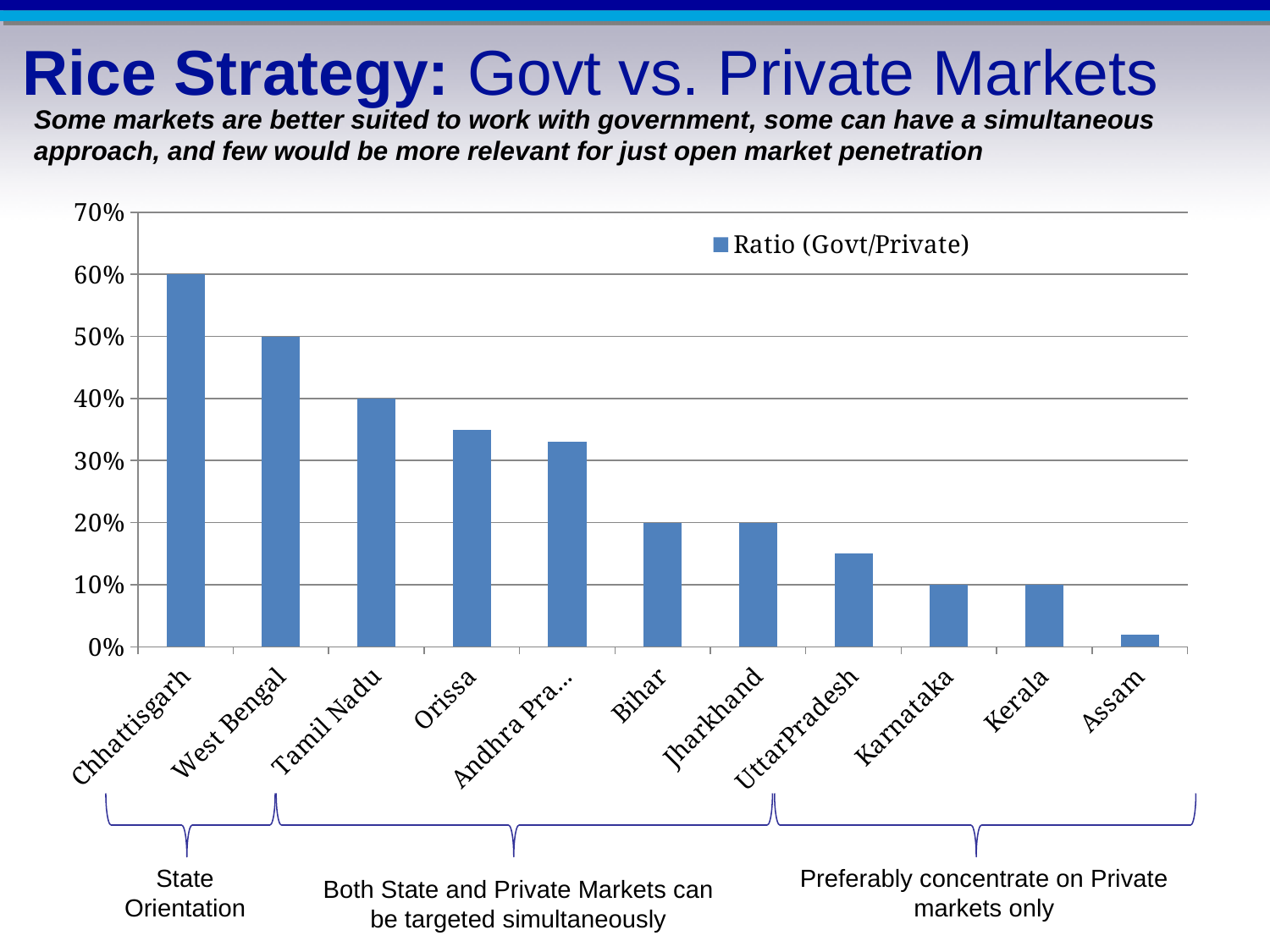
Do the values rise or fall moving from left to right along the x axis? Fall How many series does the chart legend list? 1 Is the value for Orissa greater or less than 30%? greater What is the name of the series shown in the chart legend? Ratio (Govt/Private) What type of chart is shown on the slide? Bar chart What is the Ratio (Govt/Private) for Chhattisgarh? 60% How many states are shown on the x axis of the chart? 11 Which state has the highest Ratio (Govt/Private)? Chhattisgarh Which state has the lowest Ratio (Govt/Private)? Assam Which has a larger Ratio (Govt/Private), Bihar or Karnataka? Bihar What is the Ratio (Govt/Private) for West Bengal? 50% What is the Ratio (Govt/Private) for Tamil Nadu? 40%